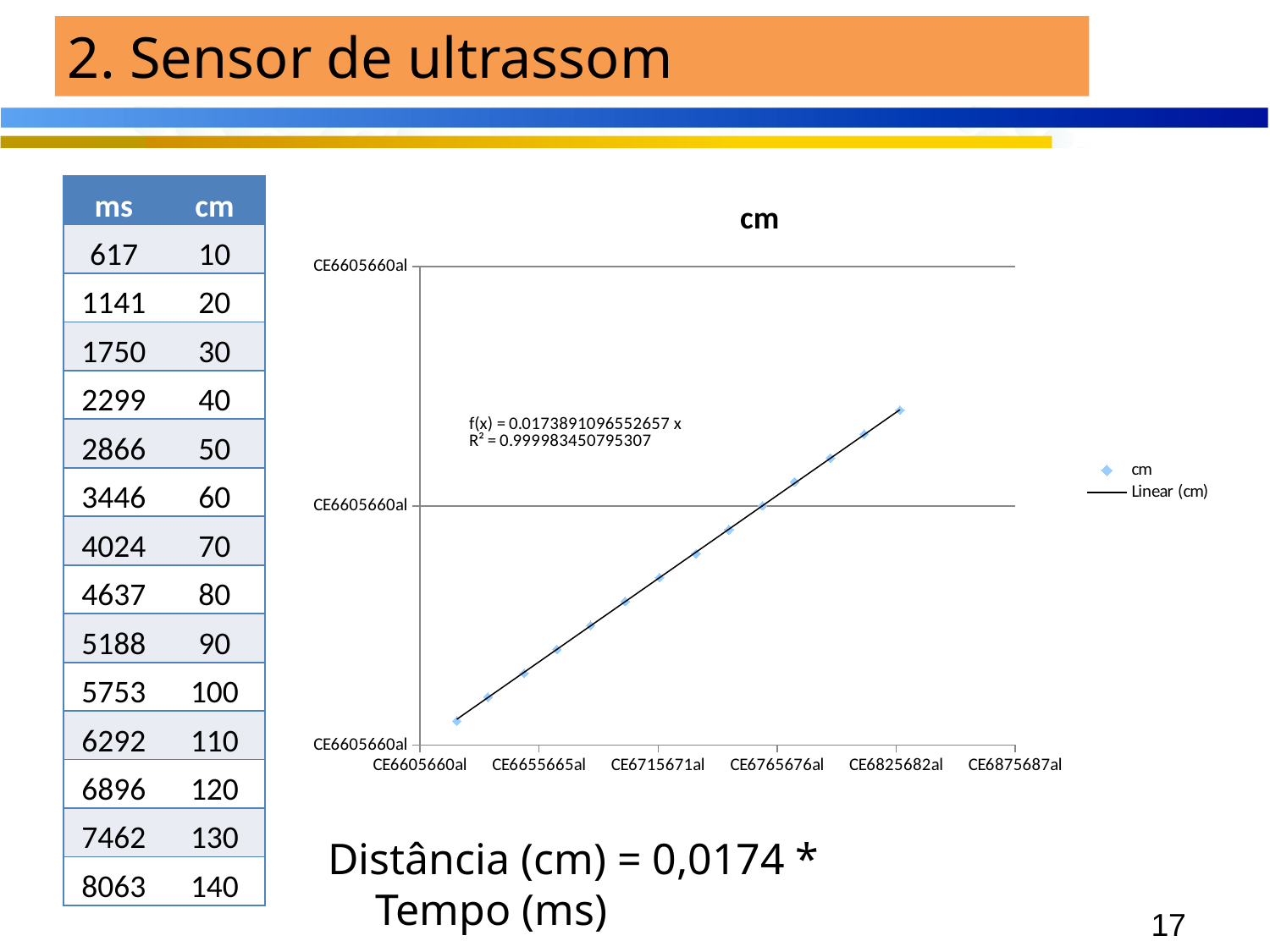
What trendline equation is printed on the chart? f(x) = 0.0173891096552657 x What R² value is printed on the chart? 0.999983450795307 How many data points are plotted in the chart? 14 How many entries does the chart legend list? 2 What kind of chart is shown on the slide? scatter chart Do the plotted values rise or fall from left to right along the x axis? rise